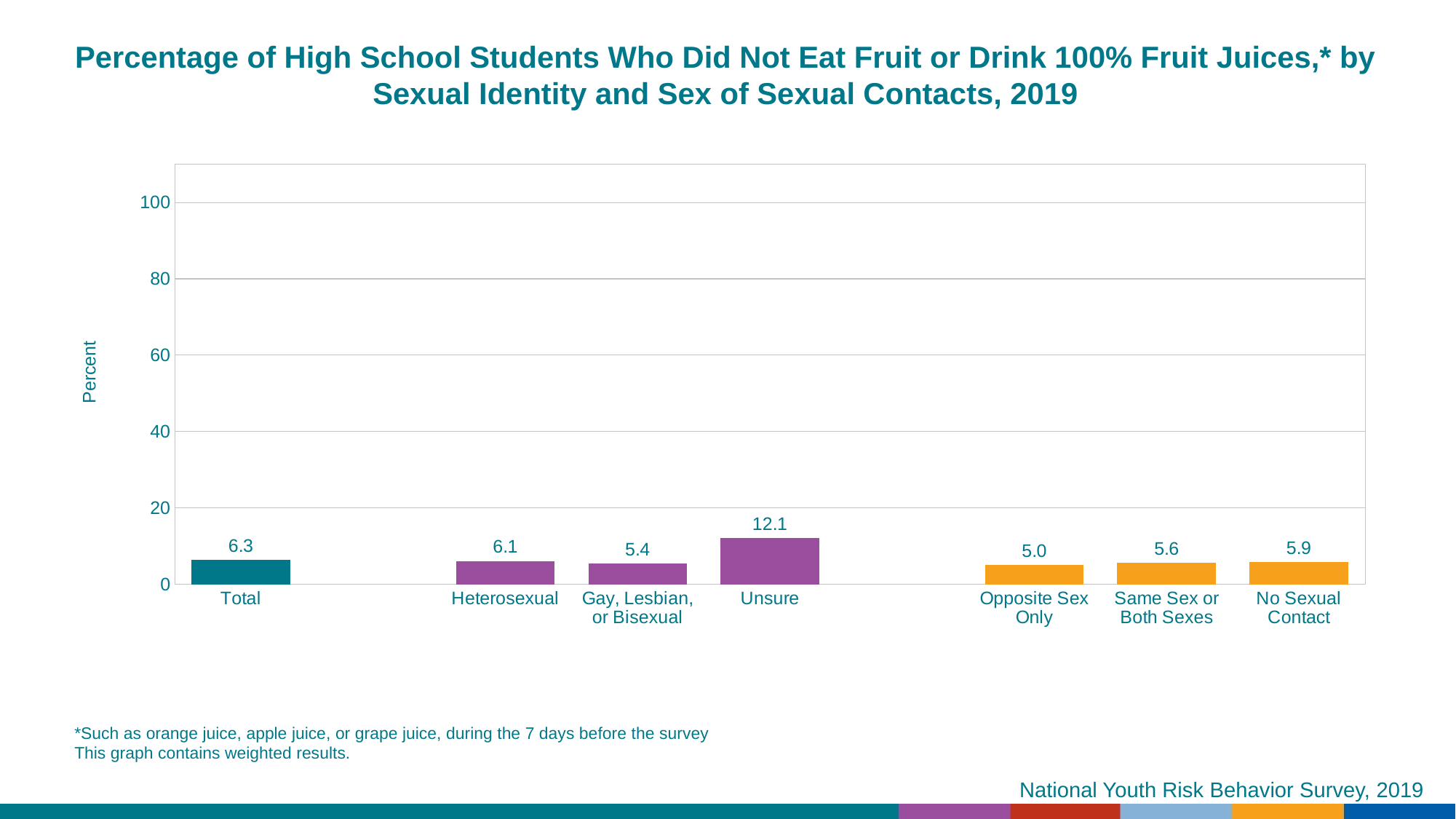
What is the value for Gay, Lesbian, or Bisexual? 5.4 What is the value for Opposite Sex Only? 5.0 Is the value for Unsure greater or less than 20? less What is the label of the y axis? Percent How many categories are shown on the x axis? 7 Which is larger, the value for No Sexual Contact or the value for Same Sex or Both Sexes? No Sexual Contact Which category has the highest value? Unsure What is the value for Total? 6.3 Which category has the lowest value? Opposite Sex Only What is the value for Unsure? 12.1 What kind of chart is shown on the slide? bar chart What is the difference between the values for Unsure and Heterosexual? 6.0